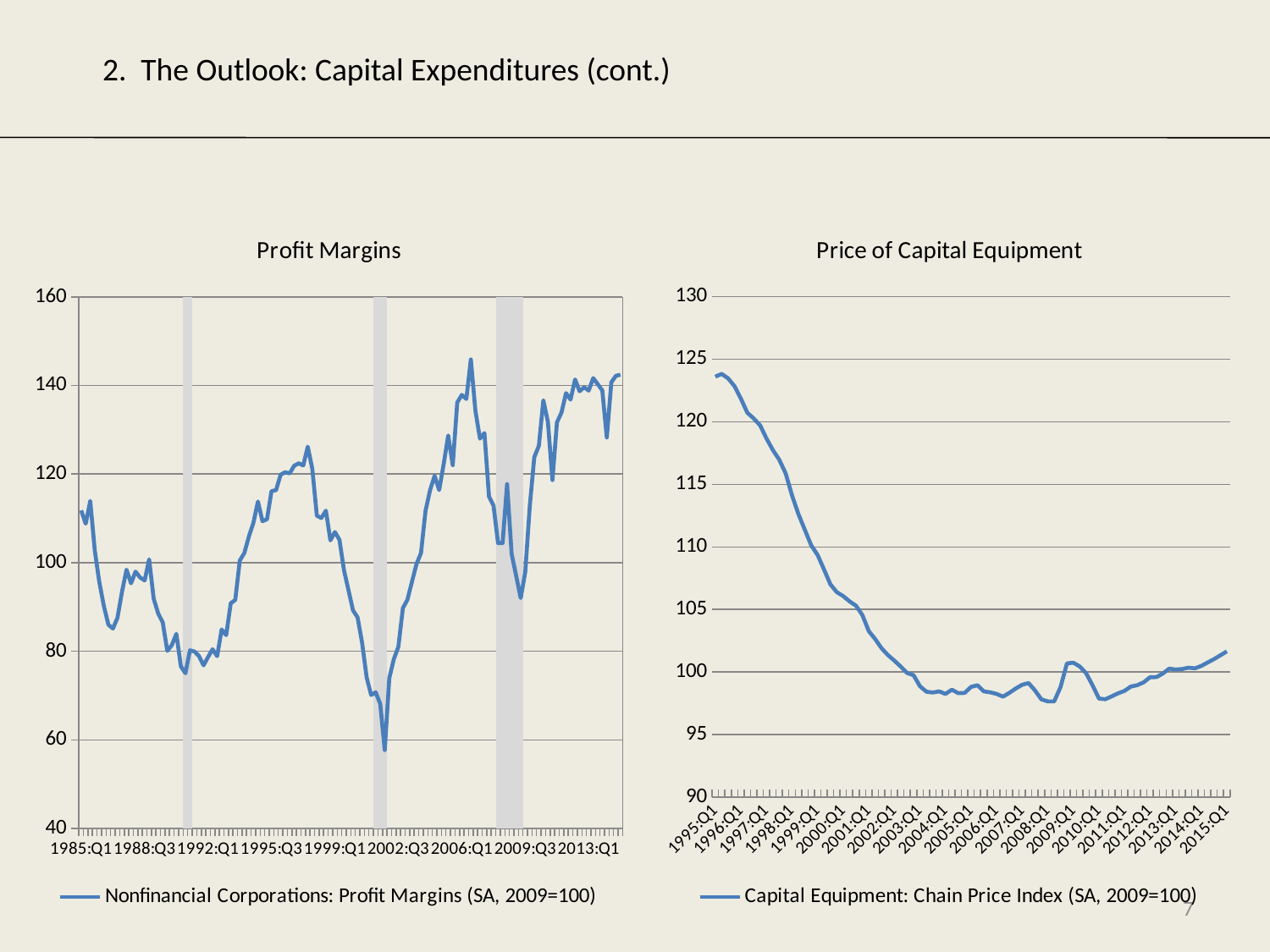
In the Price of Capital Equipment chart, which is higher, the value at 1995:Q1 or the value at 2015:Q1? 1995:Q1 What kind of chart is the Profit Margins chart? line chart In the Price of Capital Equipment chart, what is the legend entry for the plotted series? Capital Equipment: Chain Price Index (SA, 2009=100) In the Profit Margins chart, is the value at 1985:Q1 greater or less than 100? greater In the Price of Capital Equipment chart, is the value at 2015:Q1 greater or less than 105? less In the Profit Margins chart, which is higher, the value at 1985:Q1 or the value at 2013:Q1? 2013:Q1 What kind of chart is the Price of Capital Equipment chart? line chart In the Profit Margins chart, do values rise or fall between 2009:Q3 and 2013:Q1? rise In the Profit Margins chart, what is the legend entry for the plotted series? Nonfinancial Corporations: Profit Margins (SA, 2009=100) In the Price of Capital Equipment chart, is the value at 1995:Q1 greater or less than 120? greater How many series does the legend of the Profit Margins chart list? 1 In the Price of Capital Equipment chart, do values rise or fall between 1995:Q1 and 2003:Q1? fall